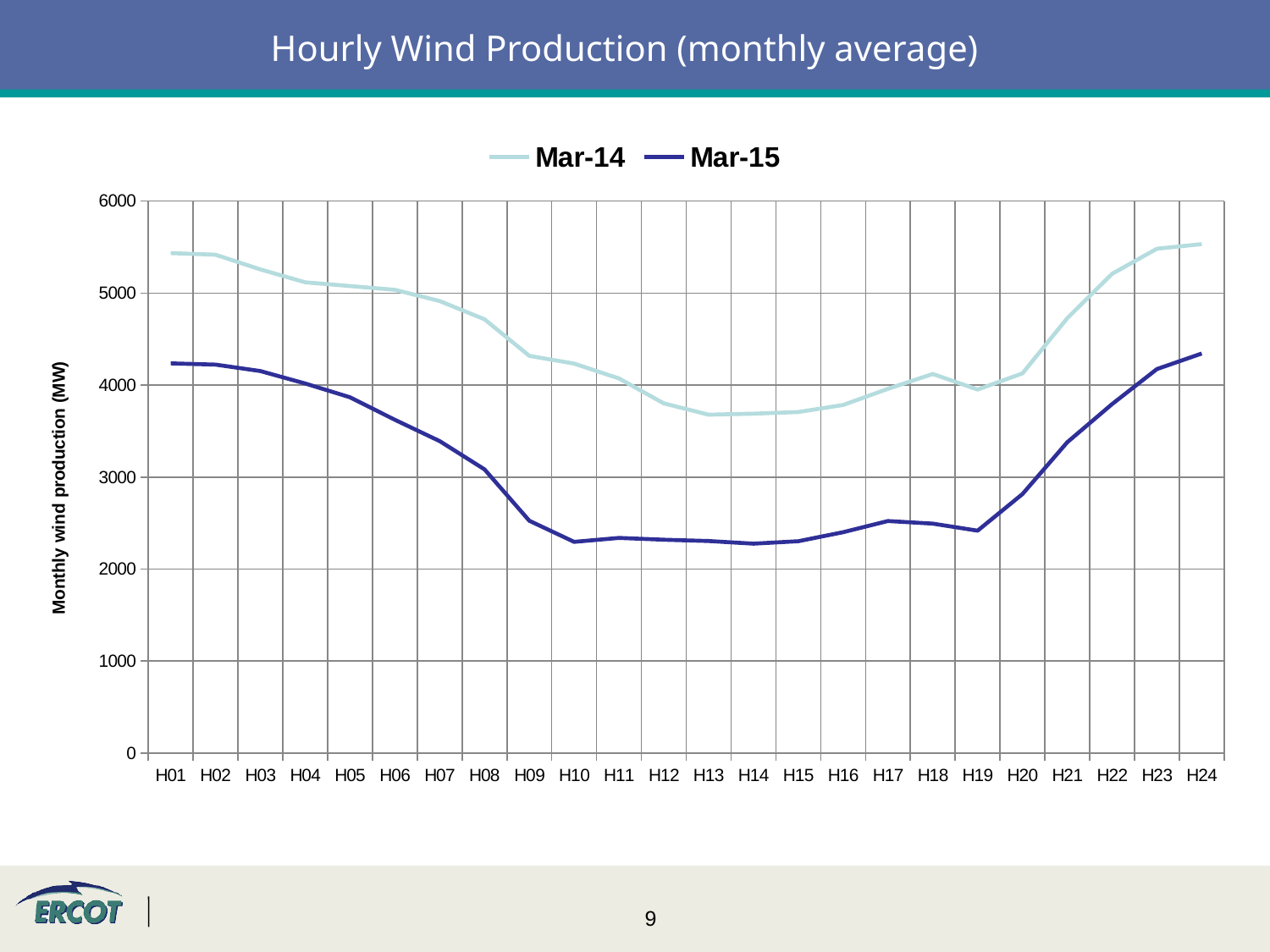
How many series does the legend list? 2 Does the Mar-15 line rise or fall from H01 to H10? fall Is the Mar-14 value at H13 greater or less than 4000? less At H12, which series has the larger value, Mar-14 or Mar-15? Mar-14 Is the Mar-15 value at H10 greater or less than 3000? less Is the Mar-14 value at H09 greater or less than 4000? greater What kind of chart is shown on the slide? line chart What is the label on the vertical axis of the chart? Monthly wind production (MW) How many hourly categories are shown on the x axis? 24 Does the Mar-14 line rise or fall from H19 to H24? rise